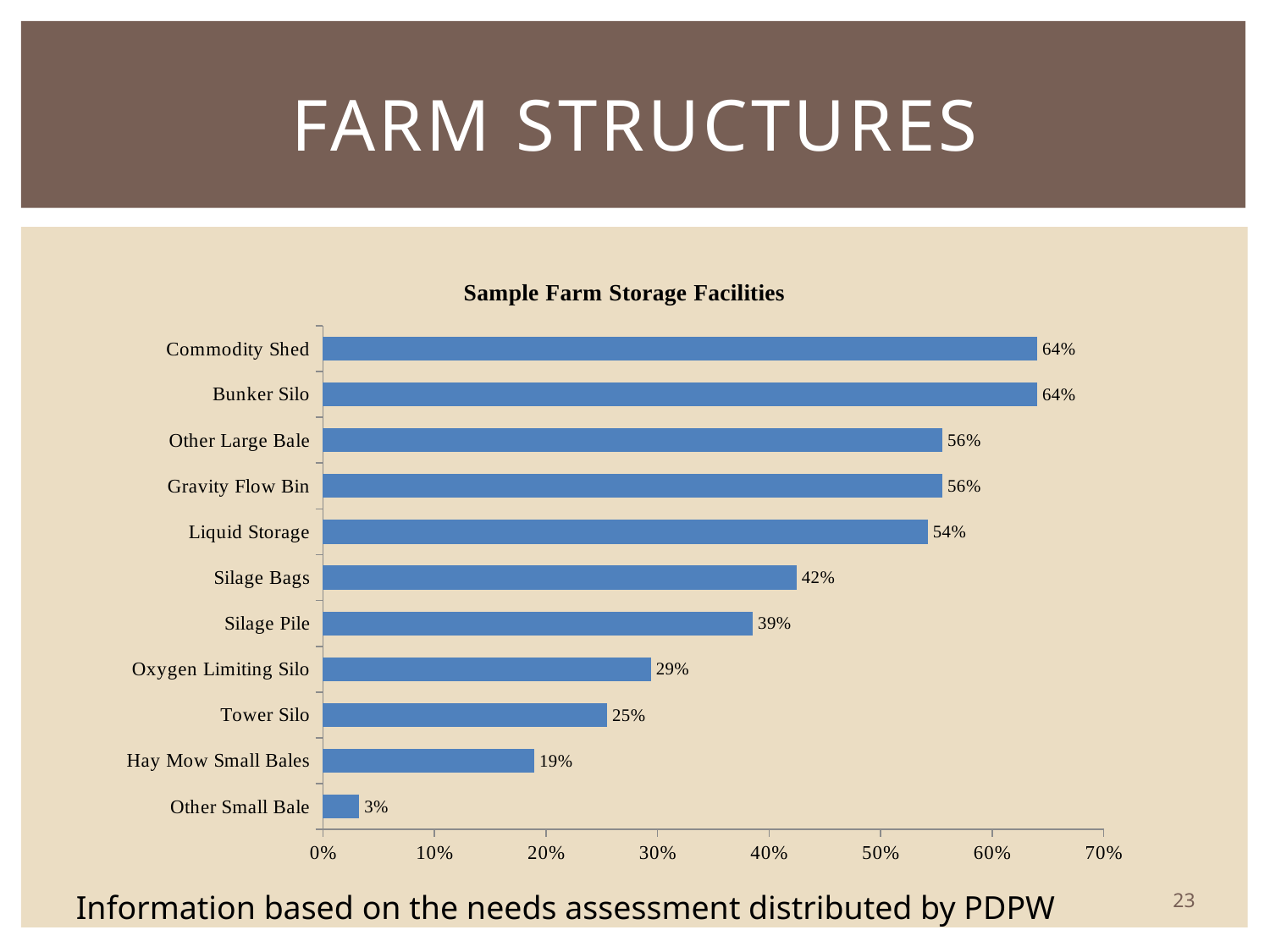
What is the difference between the values for Silage Bags and Tower Silo? 17% How many categories are shown in the chart? 11 What is the title of the chart? Sample Farm Storage Facilities What is the value for Silage Pile? 39% What kind of chart is shown on the slide? bar chart What is the difference between the values for Commodity Shed and Oxygen Limiting Silo? 35% What is the highest value shown on the x axis? 70% Which category has the lowest value? Other Small Bale Which is larger, the value for Silage Bags or the value for Silage Pile? Silage Bags What is the value for Liquid Storage? 54% Is the value for Oxygen Limiting Silo greater or less than 30%? less What is the value for Hay Mow Small Bales? 19%